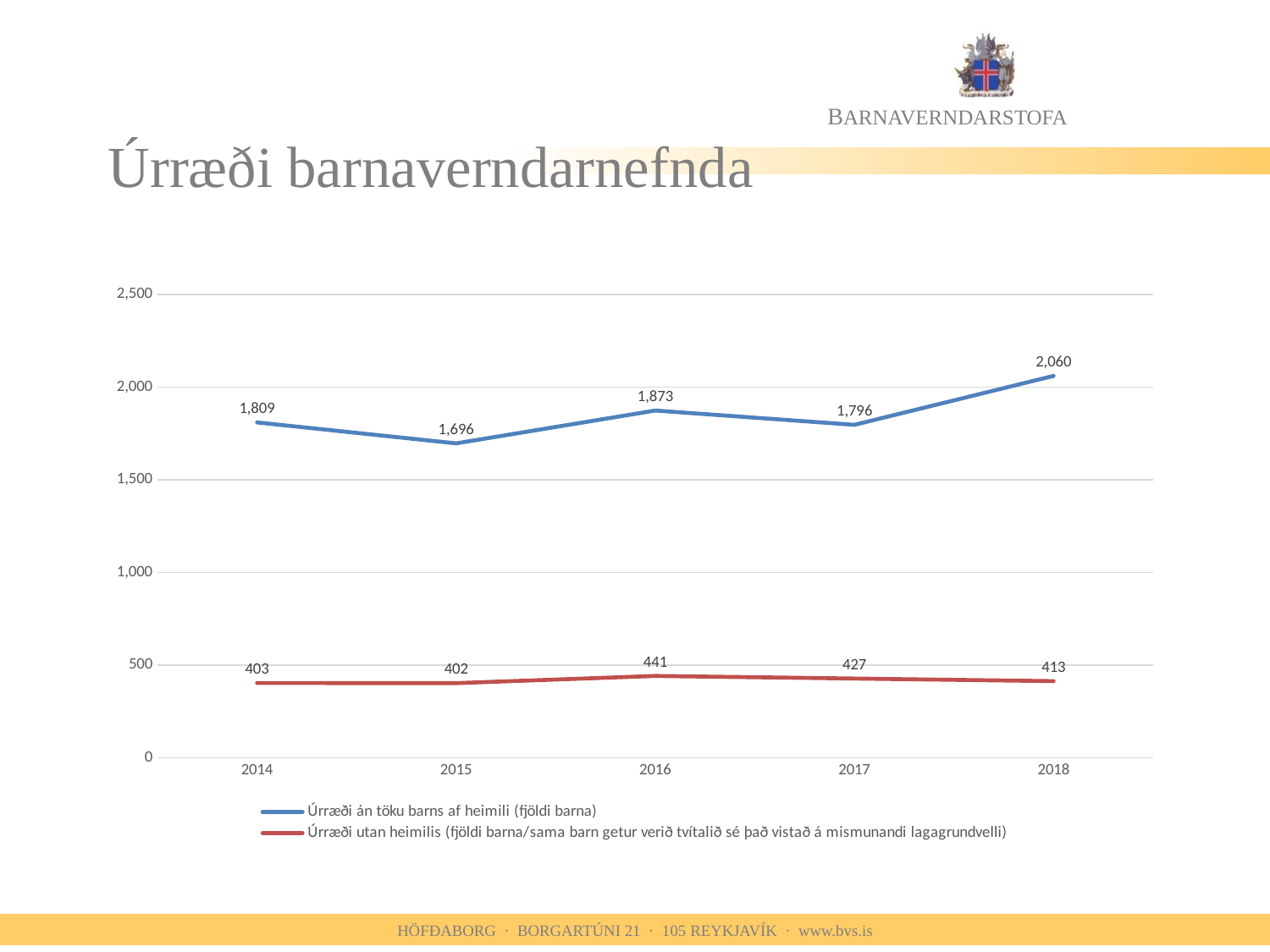
What is the value of 'Úrræði án töku barns af heimili (fjöldi barna)' in 2015? 1,696 In which year is 'Úrræði utan heimilis' lowest? 2015 What is the value of 'Úrræði án töku barns af heimili (fjöldi barna)' in 2018? 2,060 What is the difference between the 2018 and 2017 values of 'Úrræði án töku barns af heimili (fjöldi barna)'? 264 Which is larger for 'Úrræði utan heimilis': the value in 2017 or the value in 2018? 2017 What is the value of 'Úrræði utan heimilis' in 2016? 441 Is the 2016 value of 'Úrræði án töku barns af heimili (fjöldi barna)' greater or less than 2,000? less What kind of chart is shown on the slide? line chart How many series does the legend list? 2 What colour is the line for 'Úrræði utan heimilis'? red How many years are shown on the x axis? 5 In which year is 'Úrræði án töku barns af heimili (fjöldi barna)' highest? 2018